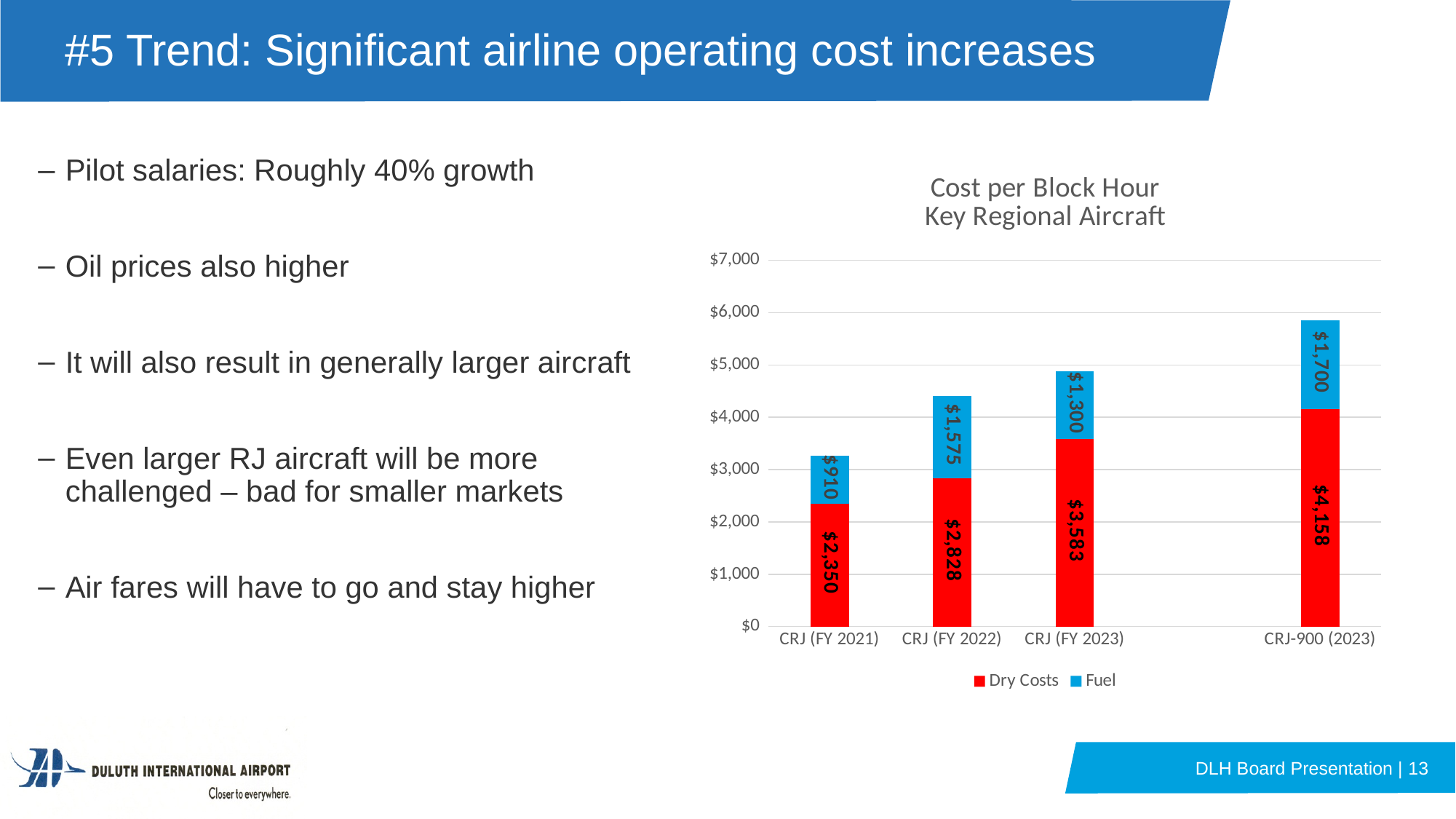
What is the Fuel value for CRJ (FY 2022)? $1,575 What is the Dry Costs value for CRJ (FY 2021)? $2,350 What is the total cost per block hour for CRJ (FY 2021), adding Dry Costs and Fuel? $3,260 What is the Dry Costs value for CRJ-900 (2023)? $4,158 What is the difference between the Dry Costs for CRJ (FY 2023) and CRJ (FY 2022)? $755 What kind of chart is shown on the slide? Stacked bar chart What is the total cost per block hour for CRJ-900 (2023), adding Dry Costs and Fuel? $5,858 How many series does the legend list? 2 How many categories are shown on the x axis? 4 Which category has the highest Fuel value? CRJ-900 (2023) Which is larger, the Fuel value for CRJ (FY 2022) or for CRJ (FY 2023)? CRJ (FY 2022) Which category has the lowest Dry Costs value? CRJ (FY 2021)